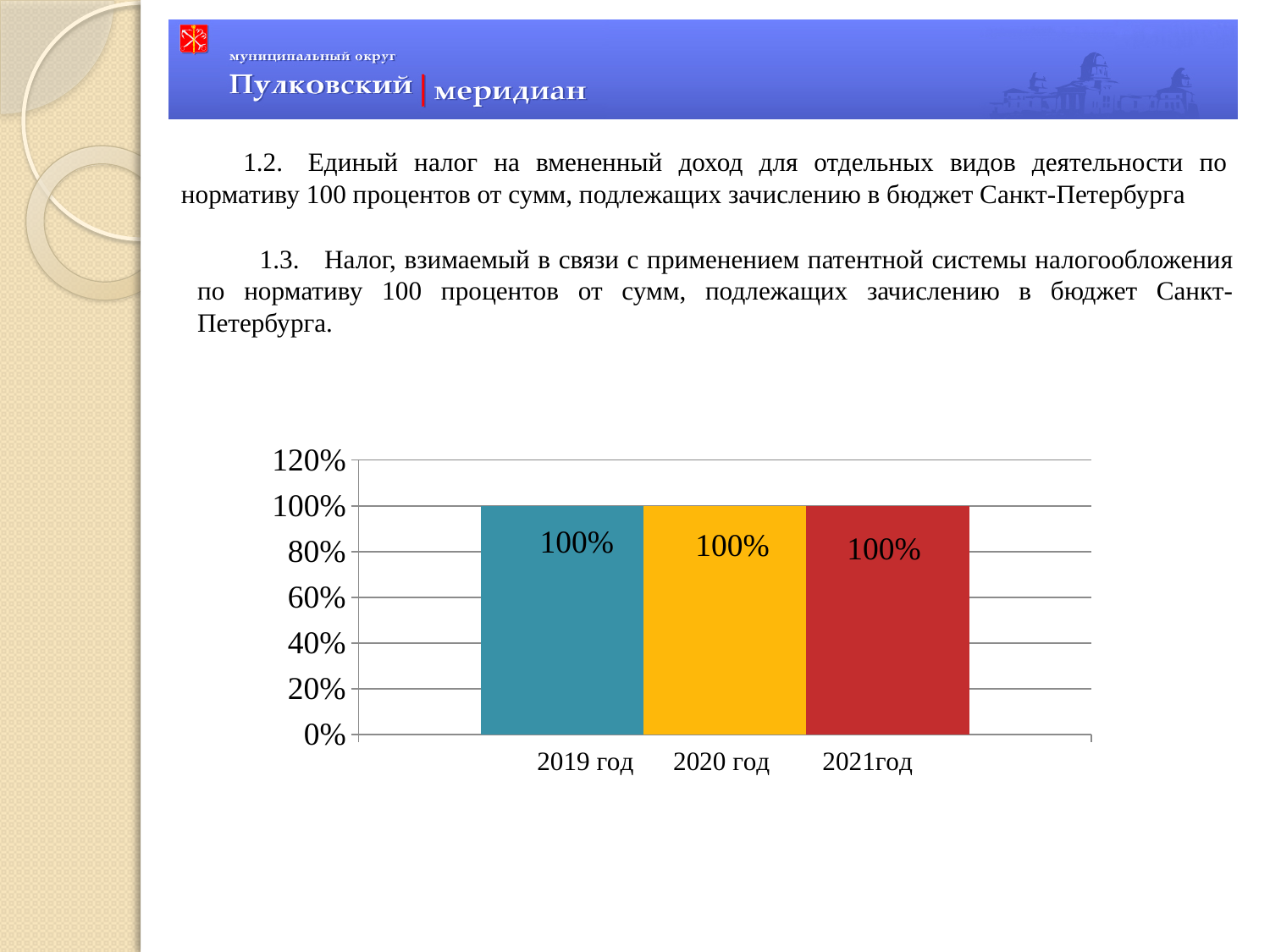
Is the value for 2021год greater or less than 80%? greater Is the value for 2020 год larger than, smaller than or equal to the value for 2019 год? equal What is the value for 2020 год? 100% What is the difference between the values for 2019 год and 2021год? 0% What colour is the bar for 2020 год? yellow What kind of chart is shown on the slide? bar chart What is the value for 2021год? 100% How many bars are plotted in the chart? 3 What is the value for 2019 год? 100% What is the highest tick shown on the vertical axis? 120% Do the values rise, fall or stay the same from 2019 год to 2021год? stay the same